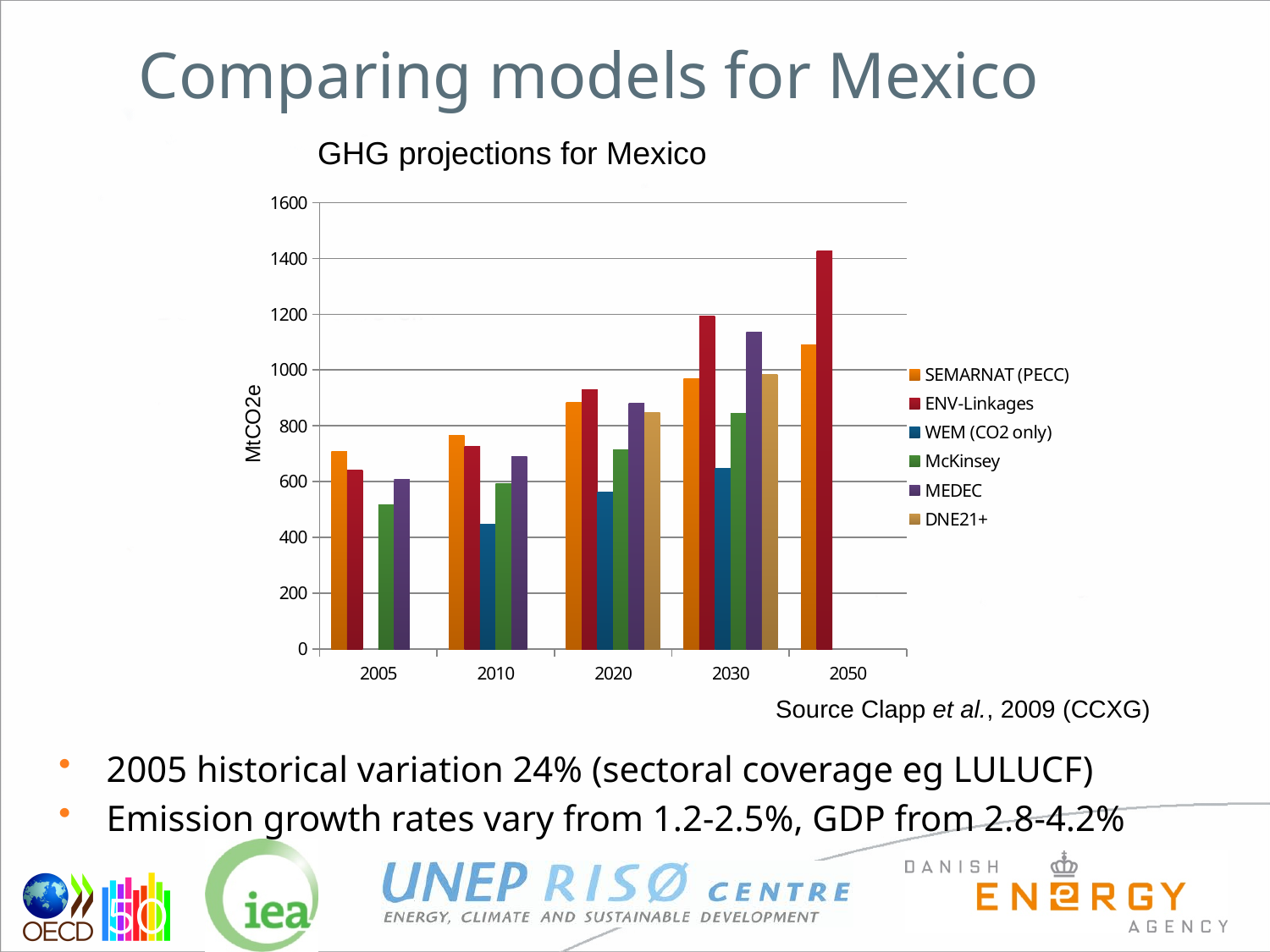
How many series does the legend list? 6 What is the label on the y axis? MtCO2e Is the value for WEM (CO2 only) in 2010 greater or less than 600? less Is the value for McKinsey in 2005 greater or less than 600? less Which series has the highest value in 2030? ENV-Linkages In 2005, which is larger: SEMARNAT (PECC) or ENV-Linkages? SEMARNAT (PECC) What type of chart is shown on the slide? bar chart Which series has the lowest value in 2020? WEM (CO2 only) Do the ENV-Linkages values rise or fall from 2005 to 2050? rise How many year categories are shown on the x axis? 5 Is the value for ENV-Linkages in 2050 greater or less than 1200? greater Which series has the highest value in 2050? ENV-Linkages